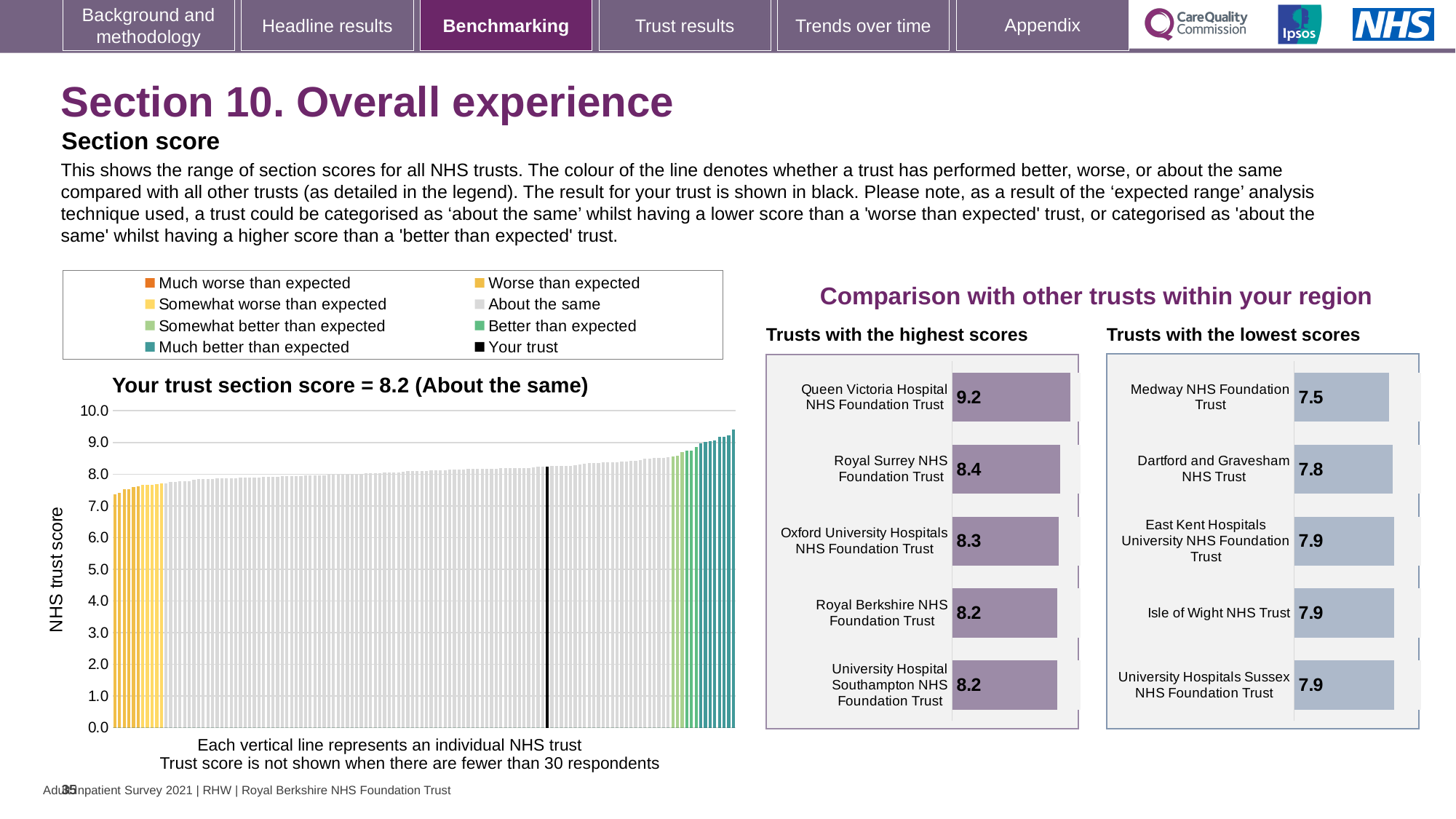
In the 'Trusts with the lowest scores' chart, which trust has the lowest score? Medway NHS Foundation Trust In the 'Trusts with the highest scores' chart, what is the difference between the scores of Queen Victoria Hospital NHS Foundation Trust and Royal Surrey NHS Foundation Trust? 0.8 In the 'Your trust section score' chart, is the value of the leftmost (lowest) bar greater or less than 7.0? greater In the 'Trusts with the lowest scores' chart, what is the score for Dartford and Gravesham NHS Trust? 7.8 In the 'Your trust section score' chart, is the value of the rightmost (highest) bar greater or less than 10.0? less In the 'Your trust section score' chart, do the bars rise or fall from left to right along the x axis? rise In the 'Your trust section score' chart, what is the label on the vertical axis? NHS trust score In the 'Your trust section score' chart, what is the trust's section score? 8.2 What kind of chart is the 'Your trust section score' chart? bar chart In the 'Trusts with the highest scores' chart, what is the score for Queen Victoria Hospital NHS Foundation Trust? 9.2 How many trusts are shown in the 'Trusts with the highest scores' chart? 5 In the 'Trusts with the highest scores' chart, which trust has the highest score? Queen Victoria Hospital NHS Foundation Trust